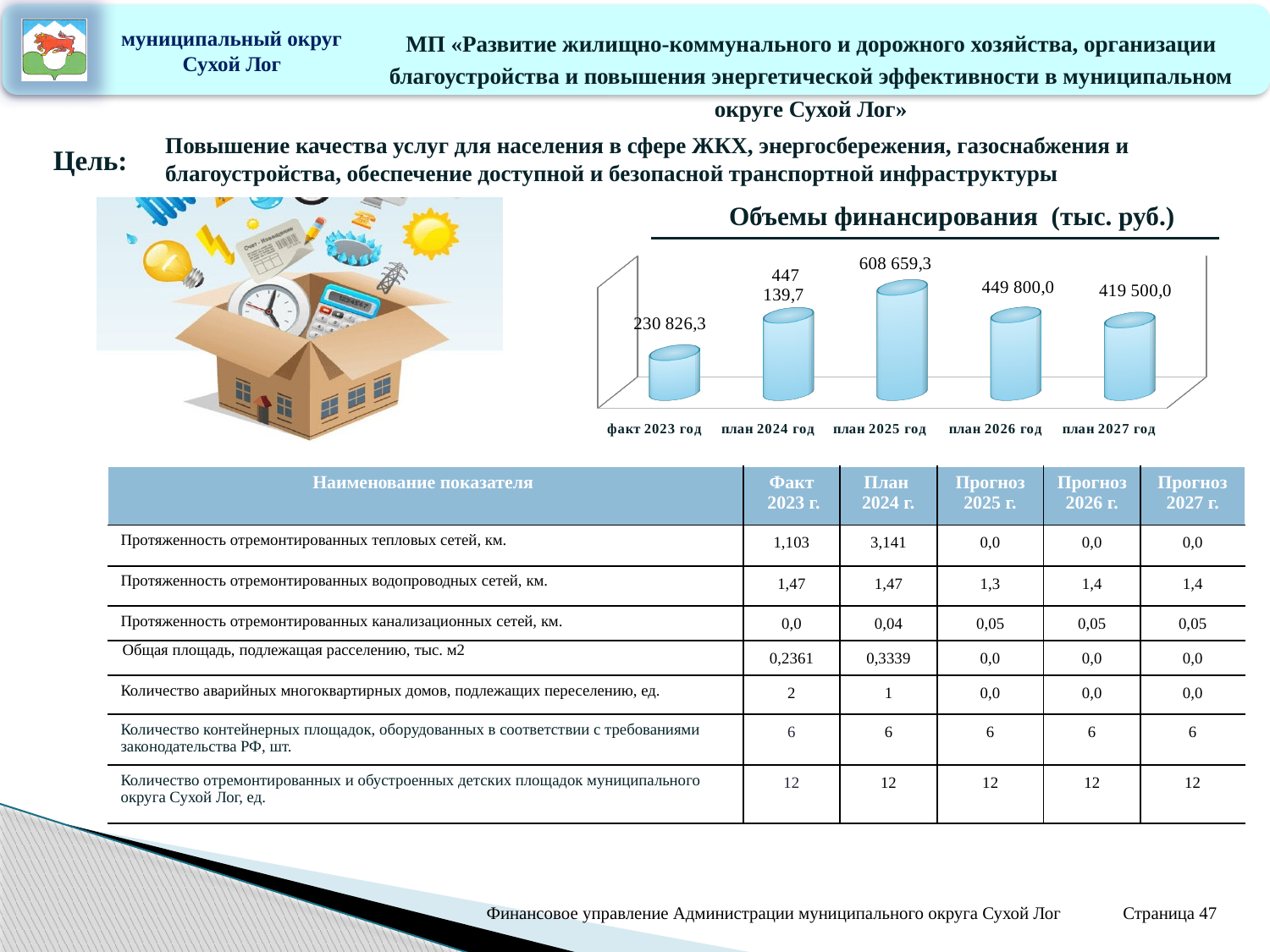
What is the difference between the values for план 2025 год and факт 2023 год in the chart «Объемы финансирования (тыс. руб.)»? 377 833,0 What is the difference between the values for план 2026 год and план 2027 год in the chart «Объемы финансирования (тыс. руб.)»? 30 300,0 How many categories are shown in the chart «Объемы финансирования (тыс. руб.)»? 5 Which category has the lowest value in the chart «Объемы финансирования (тыс. руб.)»? факт 2023 год Which is larger in the chart «Объемы финансирования (тыс. руб.)»: the value for план 2024 год or план 2026 год? план 2026 год What is the value for факт 2023 год in the chart «Объемы финансирования (тыс. руб.)»? 230 826,3 What is the value for план 2024 год in the chart «Объемы финансирования (тыс. руб.)»? 447 139,7 What is the title of the chart on the slide? Объемы финансирования (тыс. руб.) What is the value for план 2027 год in the chart «Объемы финансирования (тыс. руб.)»? 419 500,0 What kind of chart is «Объемы финансирования (тыс. руб.)»? bar chart What is the value for план 2025 год in the chart «Объемы финансирования (тыс. руб.)»? 608 659,3 Which category has the highest value in the chart «Объемы финансирования (тыс. руб.)»? план 2025 год